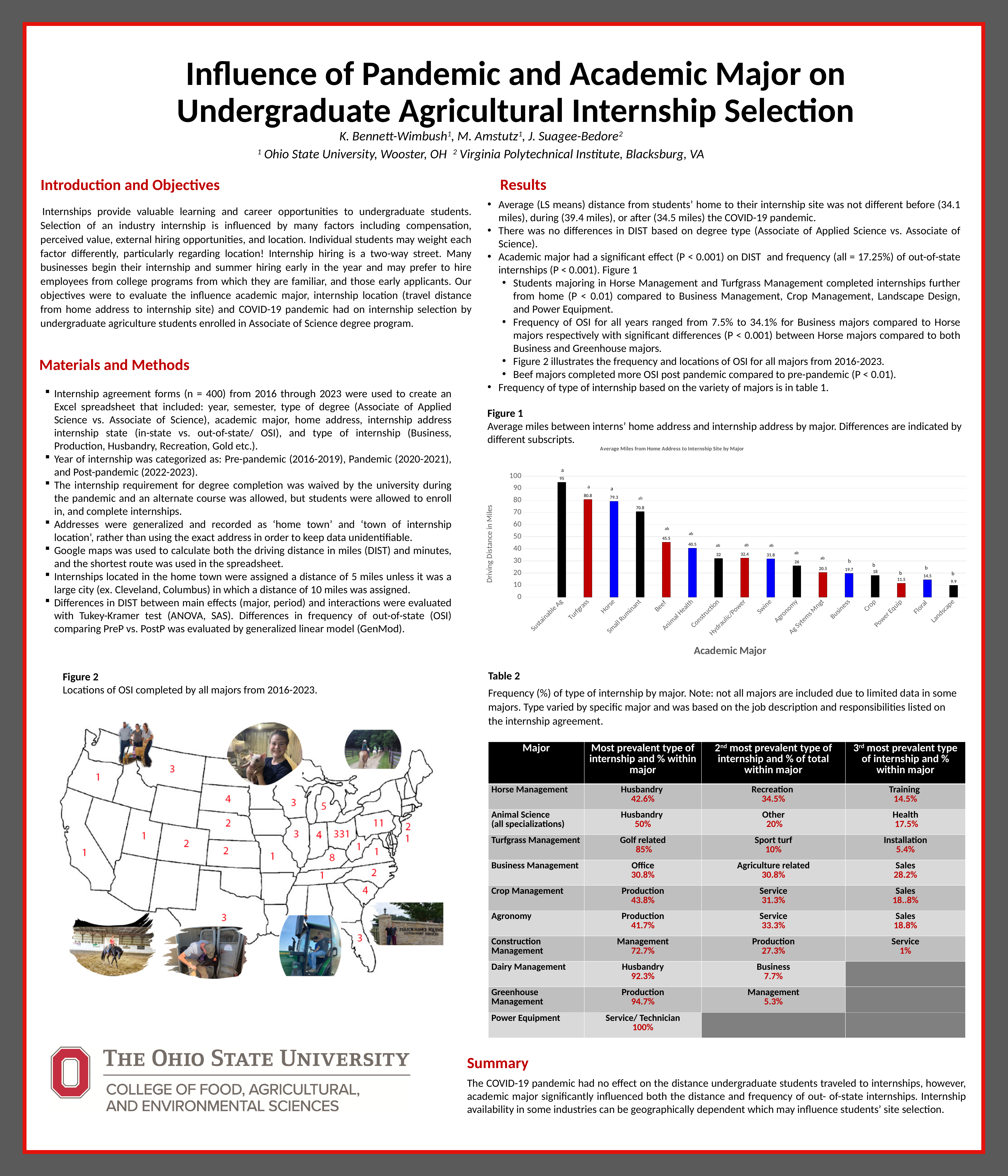
Do the values in the Figure 1 chart generally rise or fall from left to right along the x axis? Fall How many academic majors are shown on the x axis of the Figure 1 chart? 16 What kind of chart is Figure 1? Bar chart What is the value shown for Beef in the Figure 1 chart? 45.5 What is the value shown for Turfgrass in the Figure 1 chart? 80.8 Is the value for Horse in the Figure 1 chart greater or less than 70? greater Which academic major has the highest average driving distance in the Figure 1 chart? Sustainable Ag Which academic major has the lowest average driving distance in the Figure 1 chart? Landscape Which has a larger value in the Figure 1 chart, Small Ruminant or Beef? Small Ruminant What is the y-axis label of the Figure 1 chart? Driving Distance in Miles What is the average driving distance in miles for Sustainable Ag in the Figure 1 chart? 95 What is the difference between the values for Sustainable Ag and Landscape in the Figure 1 chart? 85.1